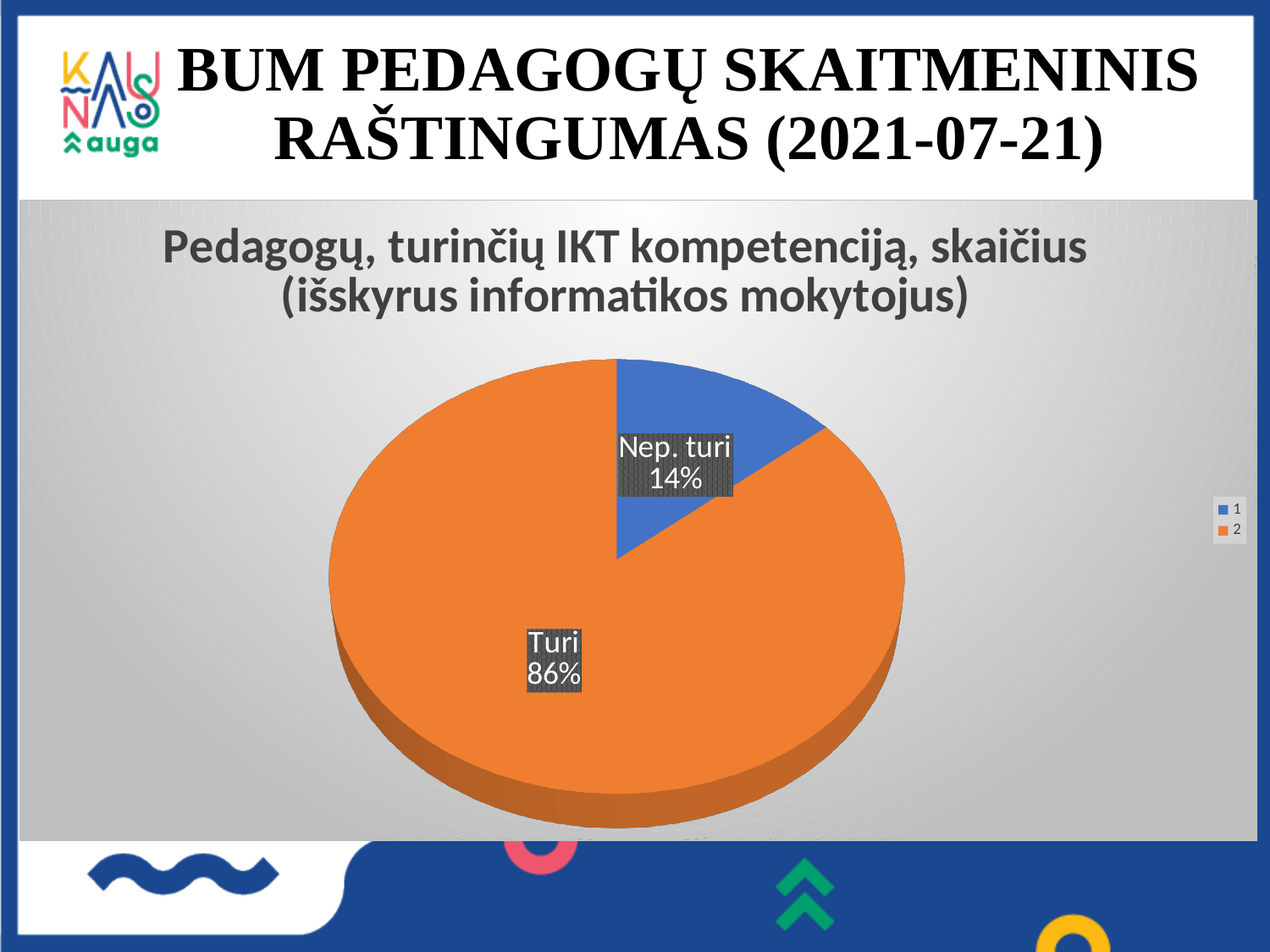
Which slice of the pie is the largest? Turi What is the title of the chart? Pedagogų, turinčių IKT kompetenciją, skaičius (išskyrus informatikos mokytojus) How many slices does the pie chart have? 2 What share of the pie does the "Nep. turi" slice represent? 14% Which is larger, the "Turi" slice or the "Nep. turi" slice? Turi What is the difference in percentage points between the "Turi" and "Nep. turi" slices? 72 How many entries does the legend list? 2 What kind of chart is shown on the slide? pie chart What colour is the "Turi" slice? orange What share of the pie does the "Turi" slice represent? 86% Which slice of the pie is the smallest? Nep. turi